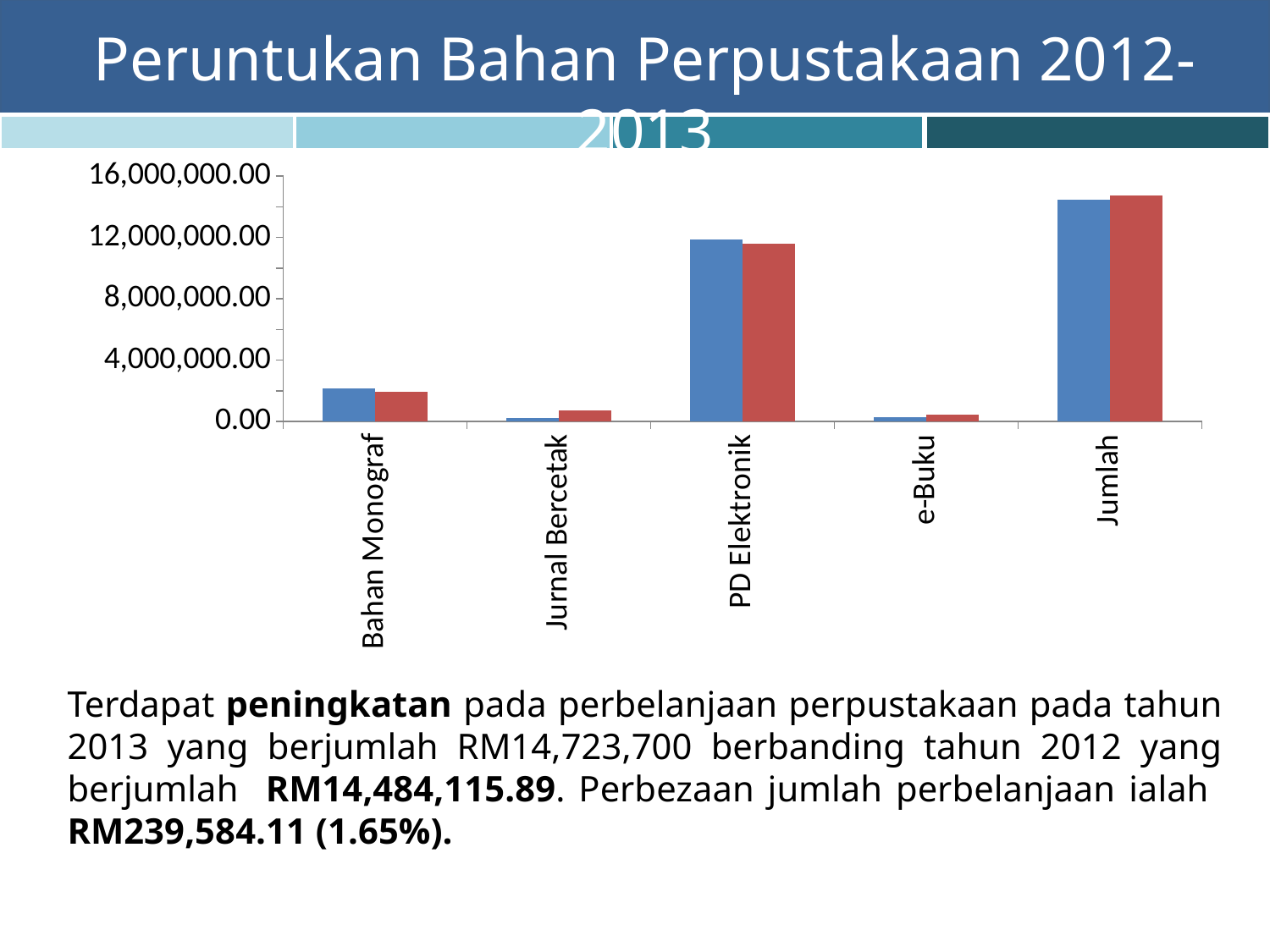
Is the red bar for Jumlah greater or less than 12,000,000.00? greater Is the blue bar for Bahan Monograf greater or less than 4,000,000.00? less Is the red bar for e-Buku greater or less than 4,000,000.00? less How many categories are shown on the x axis of the chart? 5 What kind of chart is shown on the slide? bar chart Which has the larger bars, PD Elektronik or Bahan Monograf? PD Elektronik Excluding Jumlah, which category has the tallest bars? PD Elektronik Which category has the tallest bars in the chart? Jumlah What is the title of the slide containing the chart? Peruntukan Bahan Perpustakaan 2012-2013 What is the highest value shown on the chart's vertical axis? 16,000,000.00 Which has the larger bars, Bahan Monograf or e-Buku? Bahan Monograf